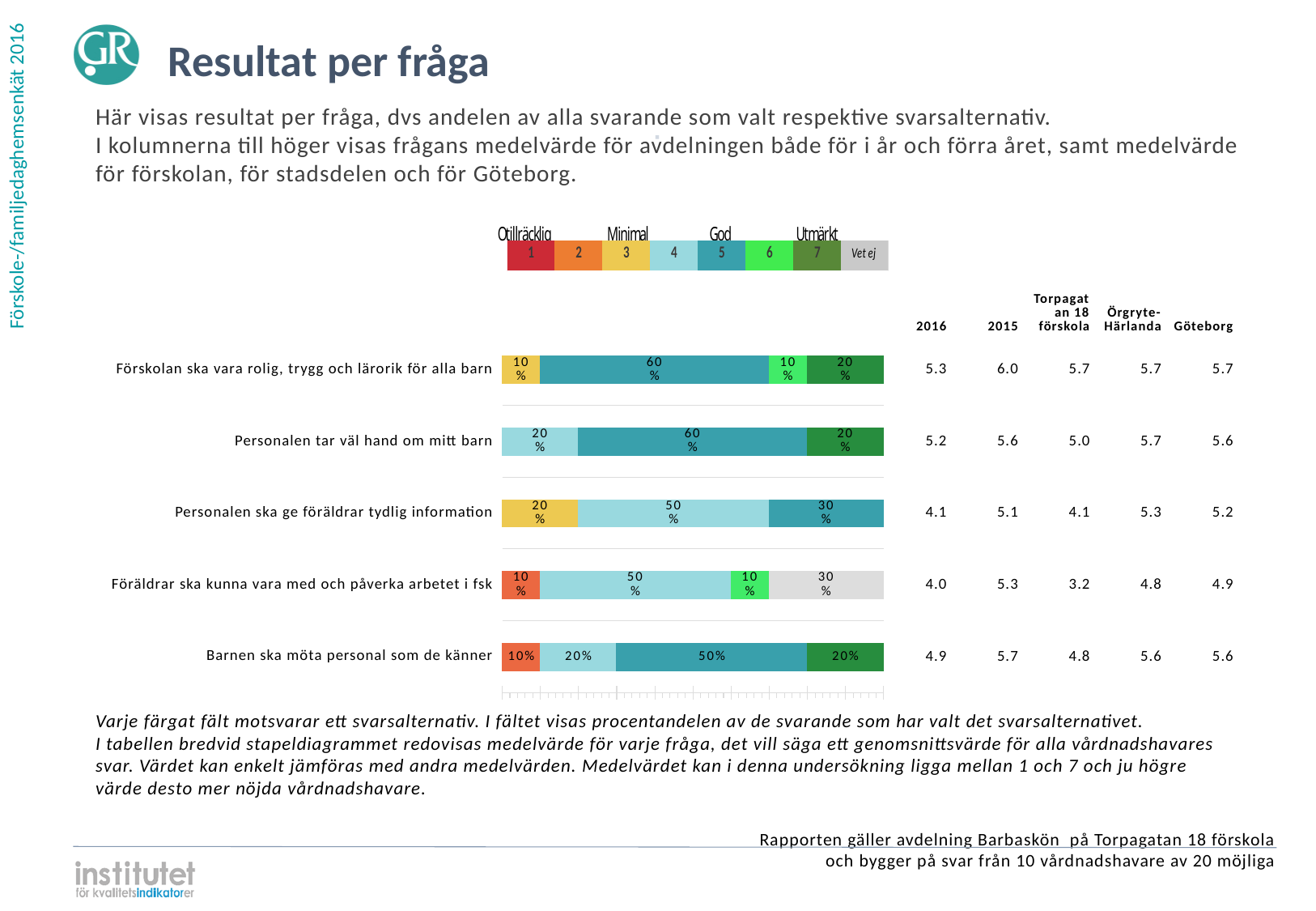
What kind of chart is used to show the share of respondents choosing each answer alternative? Stacked bar chart In the bar for 'Föräldrar ska kunna vara med och påverka arbetet i fsk', what percentage is shown for the grey 'Vet ej' segment? 30% In the bar for 'Personalen ska ge föräldrar tydlig information', what is the difference between the light blue (4) segment and the teal (5) segment? 20% In the bar for 'Barnen ska möta personal som de känner', what percentage is shown for the dark green (7) segment? 20% In the bar for 'Förskolan ska vara rolig, trygg och lärorik för alla barn', what percentage is shown for the largest (teal, 5) segment? 60% Which question has the lowest 2016 mean value in the table next to the chart? Föräldrar ska kunna vara med och påverka arbetet i fsk What is the total of the segments in the bar for 'Personalen tar väl hand om mitt barn' (20% + 60% + 20%)? 100% What is the 2016 mean value shown for 'Förskolan ska vara rolig, trygg och lärorik för alla barn'? 5.3 In the bar for 'Barnen ska möta personal som de känner', which segment is larger: the light blue (4) segment or the teal (5) segment? The teal (5) segment In the bar for 'Personalen ska ge föräldrar tydlig information', what percentage is shown for the light blue (4) segment? 50% How many answer alternatives does the colour legend above the chart list? 8 How many questions (bars) are shown in the chart? 5